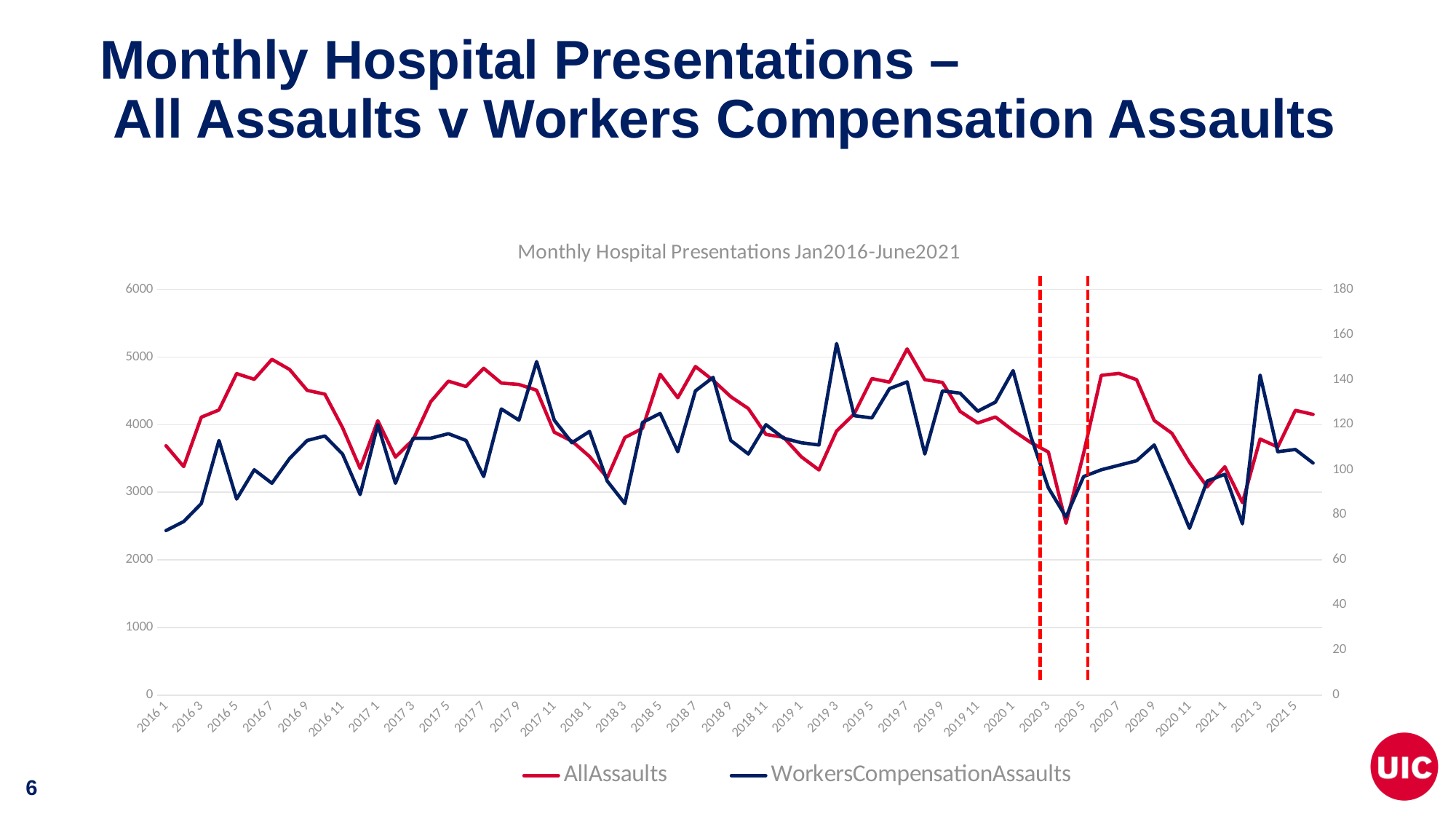
Is the AllAssaults value for 2016 7 greater or less than 4000? greater Is the AllAssaults value for 2016 1 greater or less than 4000? less What is the title of the chart? Monthly Hospital Presentations Jan2016-June2021 Is the WorkersCompensationAssaults value for 2019 3 greater or less than 140? greater Which month has the higher AllAssaults value, 2016 1 or 2016 7? 2016 7 In which month does the WorkersCompensationAssaults series reach its highest value? 2019 3 How many series does the legend list? 2 What colour is the AllAssaults line? red Does the AllAssaults line rise or fall from 2020 7 to 2020 11? fall What kind of chart is shown on the slide? line chart